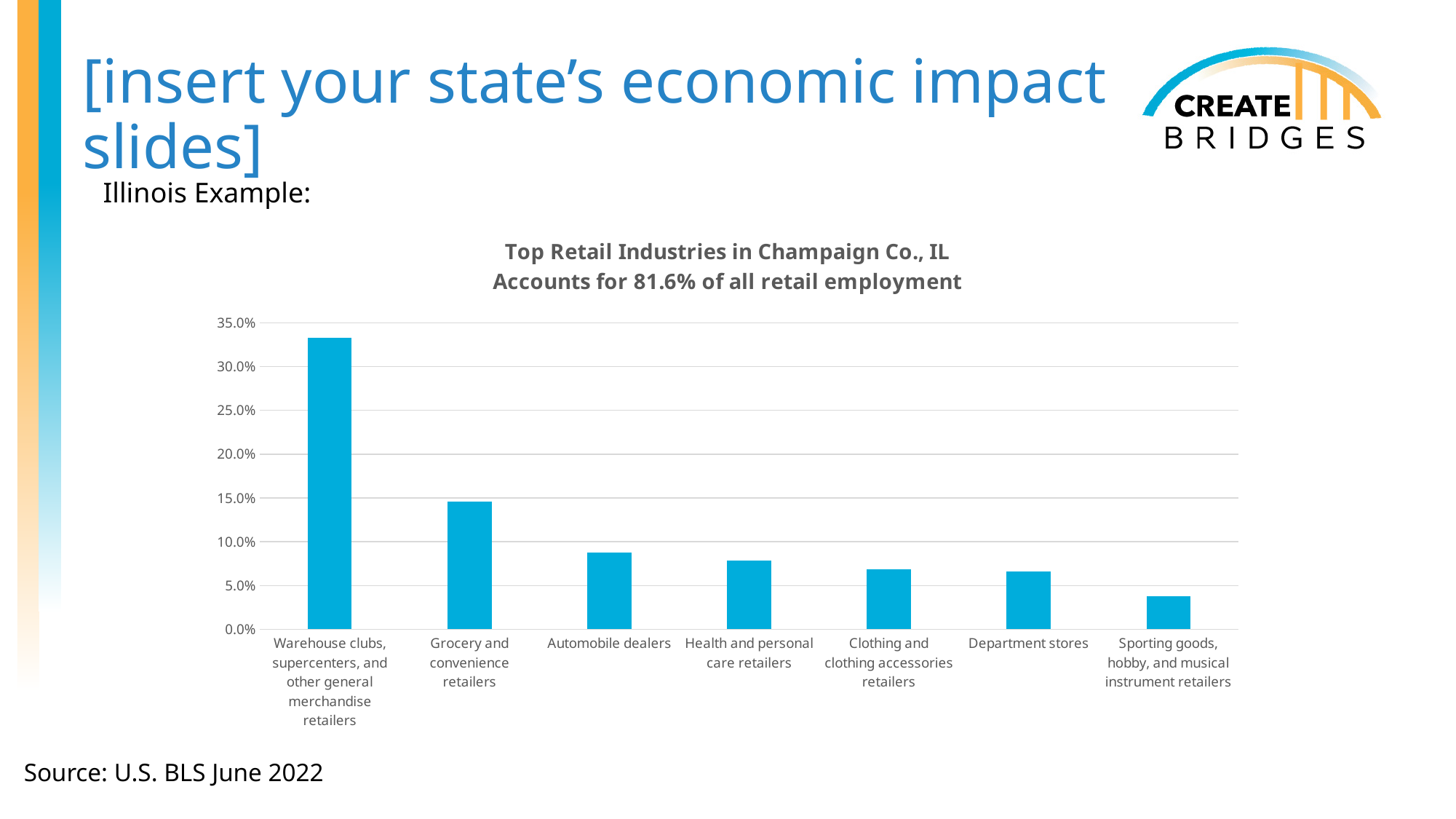
Which category has the highest share of retail employment in the chart? Warehouse clubs, supercenters, and other general merchandise retailers Is the value for Automobile dealers greater or less than 10.0%? less What kind of chart is shown on the slide? bar chart How many retail industry categories are plotted in the chart? 7 Which is larger, the value for Grocery and convenience retailers or the value for Automobile dealers? Grocery and convenience retailers Is the value for Department stores greater or less than 5.0%? greater Do the bar values rise or fall from left to right across the categories? fall Is the value for Warehouse clubs, supercenters, and other general merchandise retailers greater or less than 30.0%? greater According to the chart title, what share of all retail employment do the top retail industries in Champaign Co., IL account for? 81.6% Which category has the lowest share of retail employment in the chart? Sporting goods, hobby, and musical instrument retailers